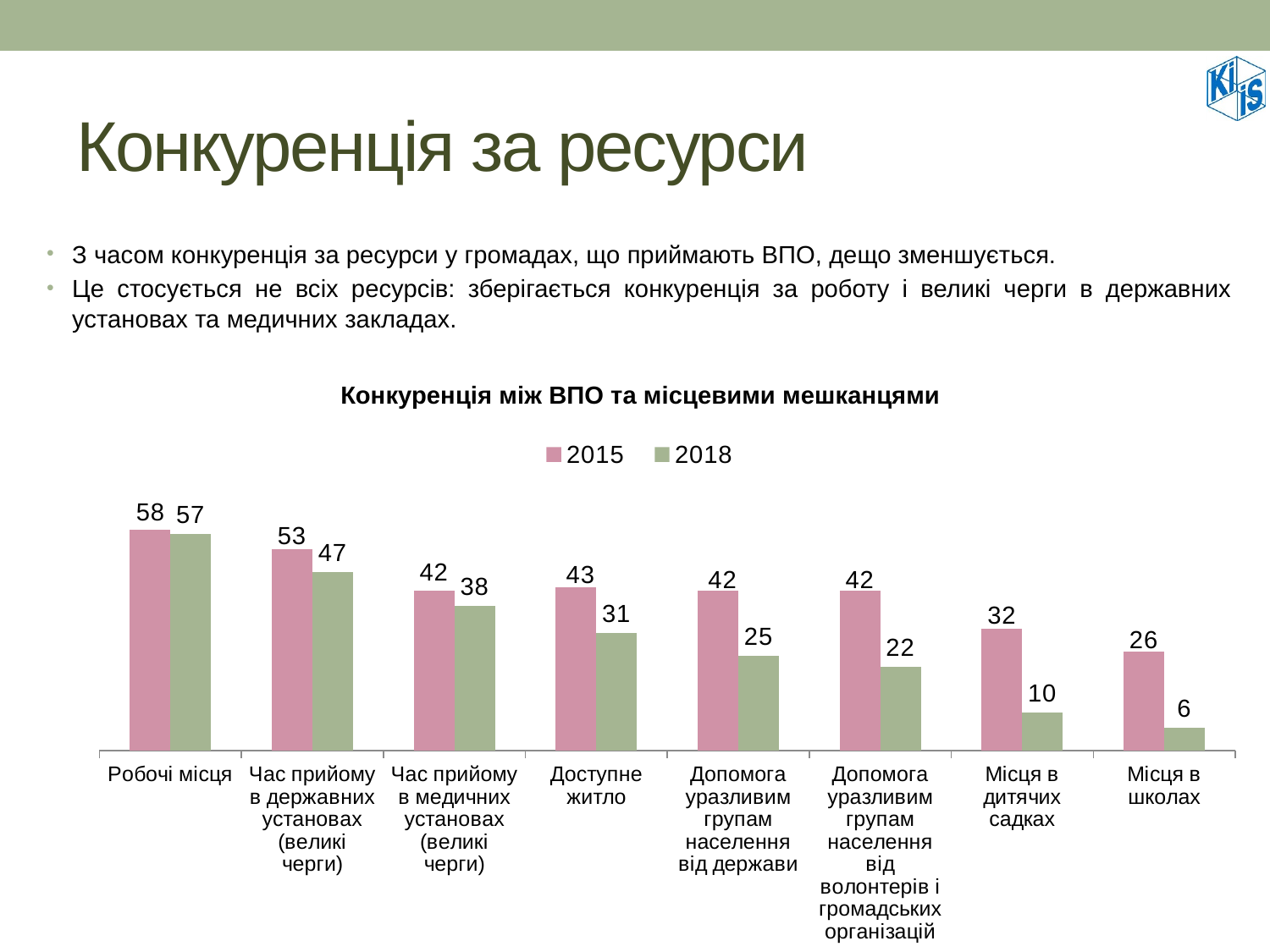
Which category has the lowest 2015 value? Місця в школах What is the 2015 value for "Робочі місця"? 58 Do the 2018 values generally rise or fall from left to right across the categories? Fall How many categories are shown on the x axis of the chart? 8 What is the difference between the 2015 and 2018 values for "Місця в дитячих садках"? 22 Which category has the highest 2018 value? Робочі місця What is the 2018 value for "Доступне житло"? 31 What is the 2018 value for "Місця в школах"? 6 What is the title of the chart? Конкуренція між ВПО та місцевими мешканцями How many series does the legend list? 2 Which is larger: the 2018 value for "Час прийому в державних установах (великі черги)" or the 2018 value for "Час прийому в медичних установах (великі черги)"? Час прийому в державних установах (великі черги) What kind of chart is shown on the slide? Bar chart